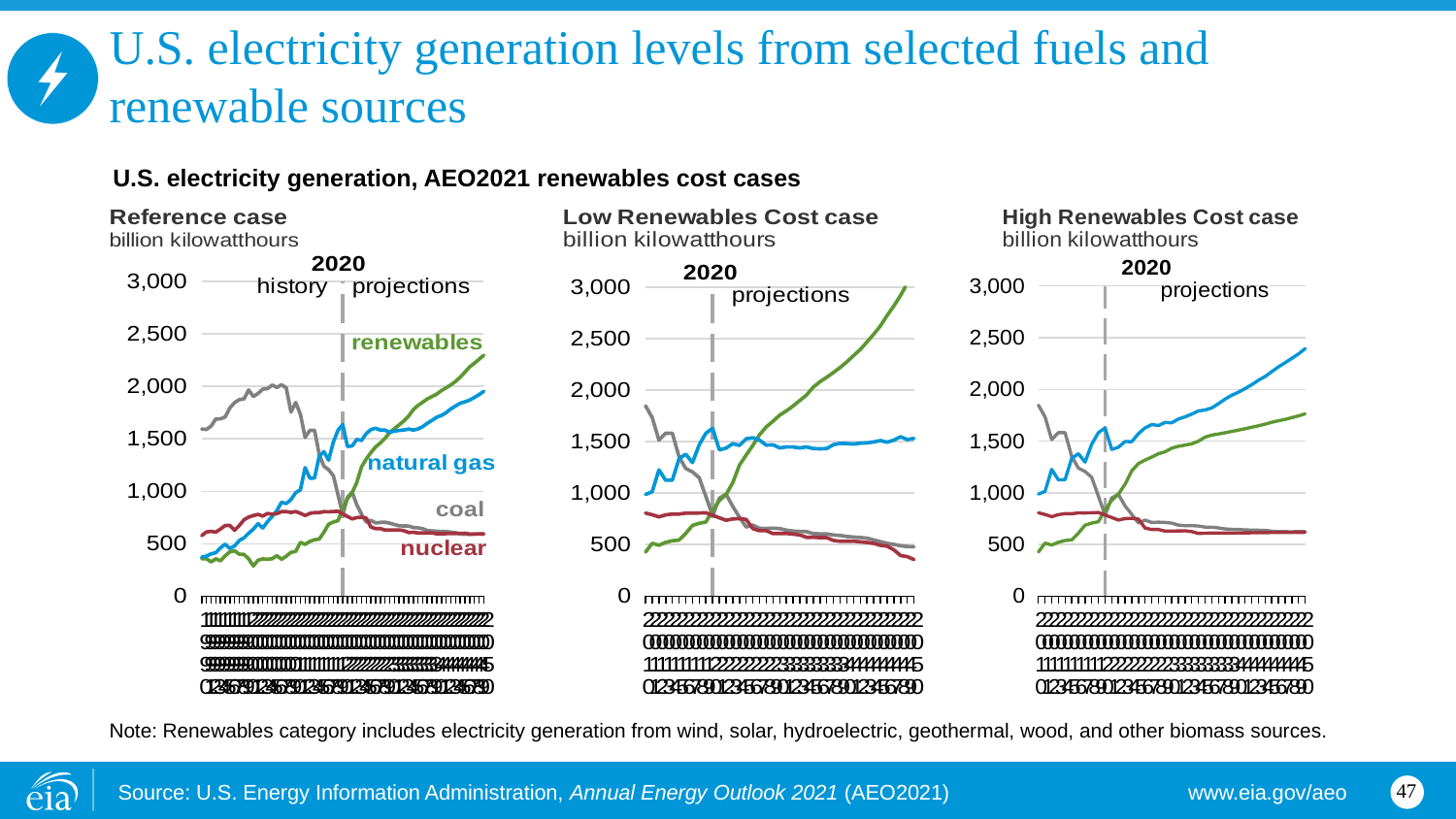
How many charts are shown on the slide? 3 In the Reference case chart, which series has the highest value at the end of the projection period? renewables In the Reference case chart, does the renewables line rise or fall over the projection period? rise In the Reference case chart, does the coal line rise or fall over the projection period? fall In the Reference case chart, is the natural gas value at the end of the projections greater or less than 1,500? greater In the Low Renewables Cost case chart, is the green (renewables) line at the end of the projections greater or less than 2,500? greater What kind of chart is the Reference case chart? line chart In the Reference case chart, how many series are labelled? 4 In the High Renewables Cost case chart, which is higher at the end of the projections, the blue (natural gas) line or the green (renewables) line? blue (natural gas) In the Reference case chart, is the renewables value at the end of the projections greater or less than 2,000? greater What year does the vertical dashed line mark in each chart? 2020